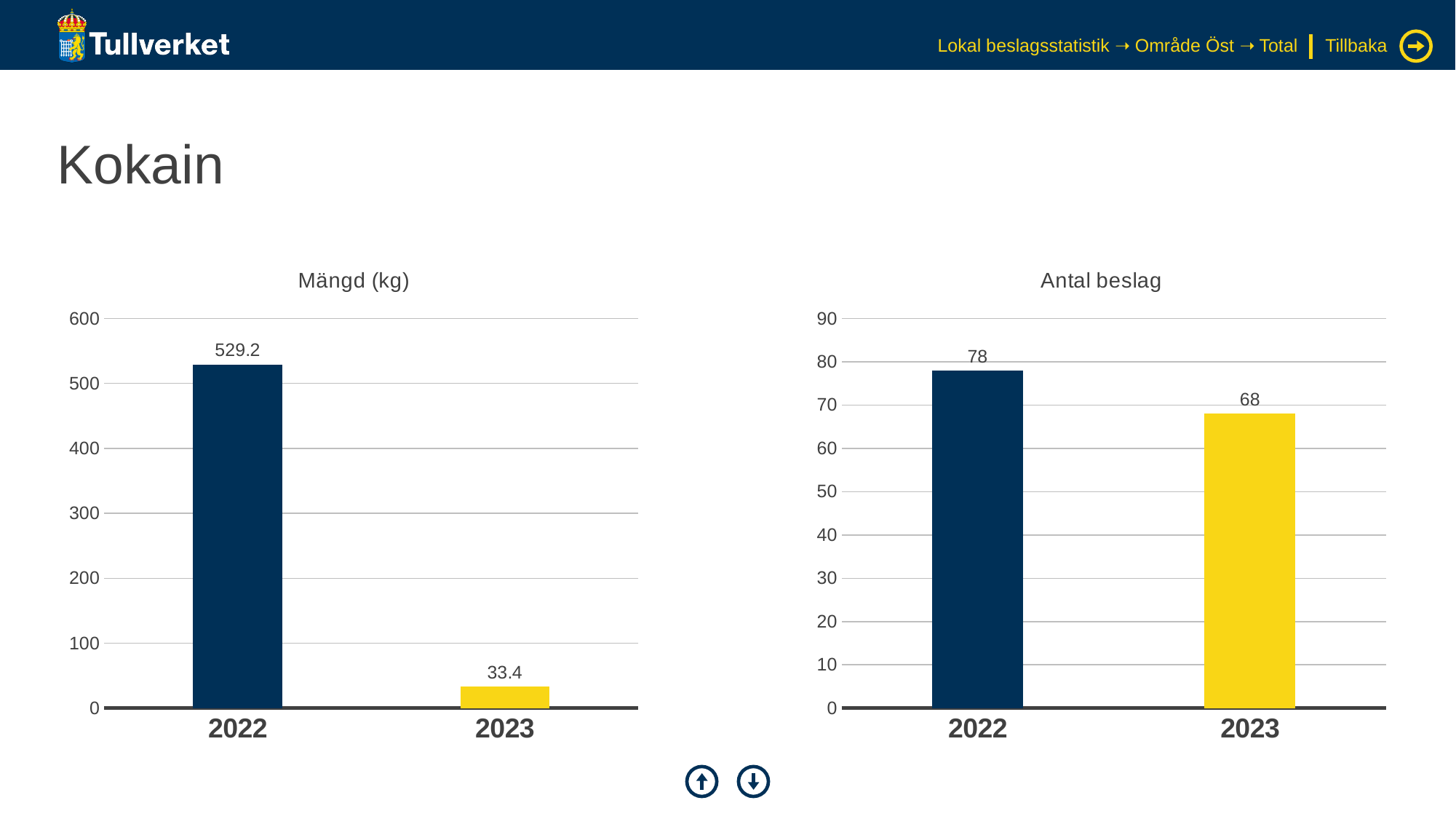
In the 'Antal beslag' chart, what is the value for 2023? 68 How many categories are shown on the x axis of the 'Antal beslag' chart? 2 What kind of chart is the 'Mängd (kg)' chart? bar chart In the 'Antal beslag' chart, is the value for 2022 or 2023 larger? 2022 In the 'Mängd (kg)' chart, what is the value for 2023? 33.4 In the 'Mängd (kg)' chart, what is the value for 2022? 529.2 In the 'Mängd (kg)' chart, what is the difference between the 2022 and 2023 values? 495.8 In the 'Mängd (kg)' chart, which year has the highest value? 2022 In the 'Antal beslag' chart, what is the difference between the 2022 and 2023 values? 10 In the 'Mängd (kg)' chart, is the value for 2022 greater or less than 500? greater In the 'Antal beslag' chart, which year has the lowest value? 2023 In the 'Antal beslag' chart, what is the value for 2022? 78